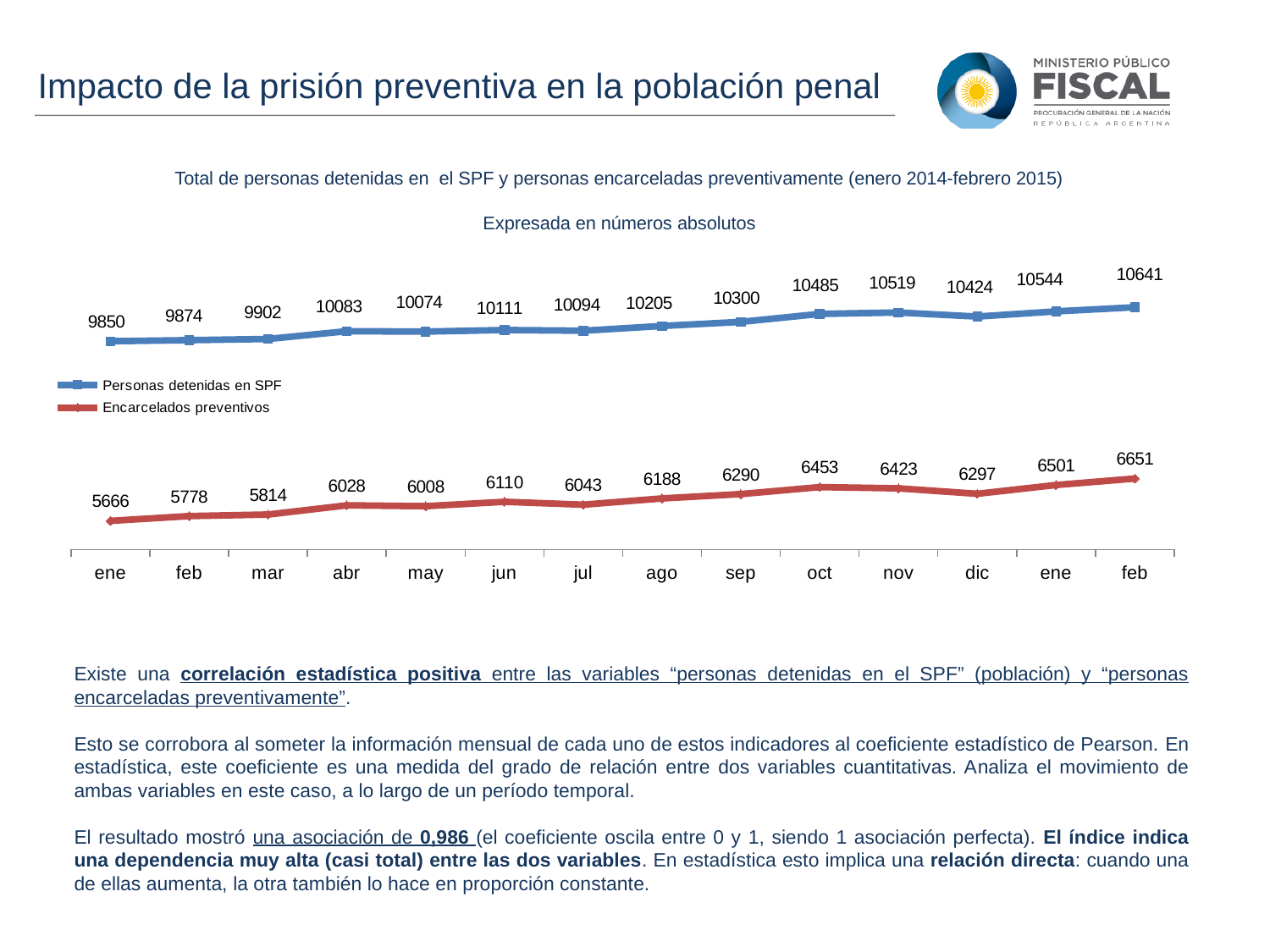
Which is larger: 'Encarcelados preventivos' in nov or in dic? nov (6423) How many monthly data points does each line in the chart have? 14 What is the value of 'Encarcelados preventivos' for the first ene on the x axis? 5666 In which month does 'Personas detenidas en SPF' reach its highest value? feb (the last point, 10641) What is the value of 'Personas detenidas en SPF' for sep? 10300 What type of chart is shown on the slide? line chart Overall, do the values of 'Personas detenidas en SPF' rise or fall from the first ene to the last feb? rise What is the value of 'Encarcelados preventivos' for oct? 6453 In which month is 'Encarcelados preventivos' at its lowest value? ene (the first point, 5666) What is the difference between 'Personas detenidas en SPF' and 'Encarcelados preventivos' in dic? 4127 How many series does the chart legend list? 2 Which series is drawn in red in the chart? Encarcelados preventivos